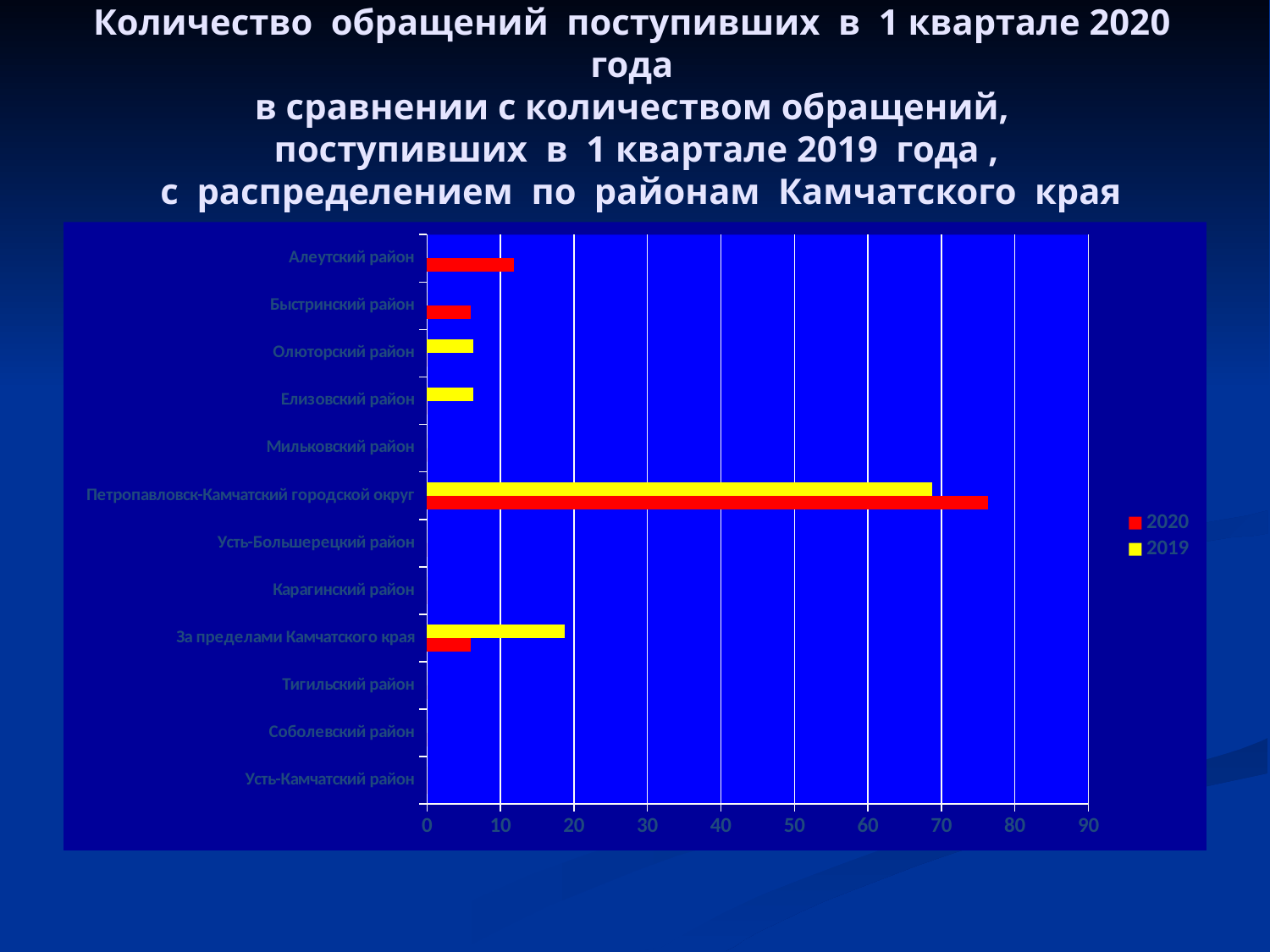
Which category has the highest value for 2019? Петропавловск-Камчатский городской округ Is the 2020 value for Петропавловск-Камчатский городской округ greater or less than 70? greater What kind of chart is shown on the slide? bar chart How many districts (categories) are shown on the vertical axis? 12 For За пределами Камчатского края, which is larger: the 2019 value or the 2020 value? 2019 How many series does the legend list? 2 Which years are listed in the legend? 2020 and 2019 Is the 2019 value for За пределами Камчатского края greater or less than 10? greater Which category has the highest value for 2020? Петропавловск-Камчатский городской округ Which colour represents the 2020 series? red For Петропавловск-Камчатский городской округ, which is larger: the 2020 value or the 2019 value? 2020 Is the 2019 value for Петропавловск-Камчатский городской округ greater or less than 70? less